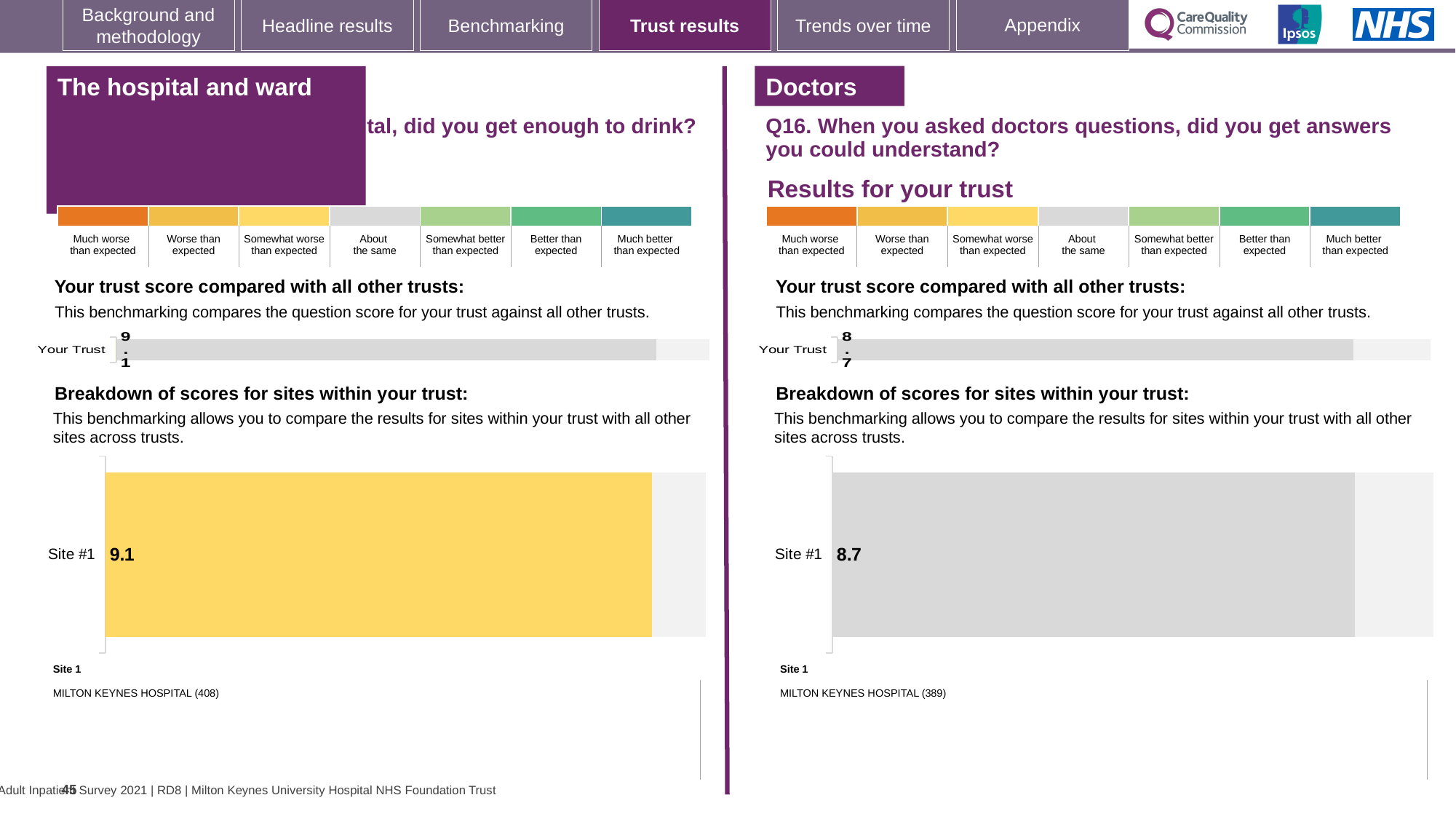
How many sites are plotted in the right-hand 'Breakdown of scores for sites within your trust' chart (Q16, Doctors)? 1 Which Site #1 score is larger: the one in the left-hand breakdown chart or the one in the right-hand (Q16, Doctors) breakdown chart? The left-hand chart (9.1) In the right-hand 'Breakdown of scores for sites within your trust' chart (Q16, Doctors), what is the score for Site #1? 8.7 What type of chart is used to show the Site #1 score in the left-hand 'Breakdown of scores for sites within your trust' section? Bar chart In the left-hand 'Your trust score compared with all other trusts' chart, what is the value shown for Your Trust? 9.1 What is the difference between the Site #1 score in the left-hand breakdown chart and the Site #1 score in the right-hand (Q16, Doctors) breakdown chart? 0.4 How many bars are plotted in the left-hand 'Your trust score compared with all other trusts' chart? 1 In the right-hand (Q16, Doctors) breakdown chart, which site name is listed for Site 1 below the chart? MILTON KEYNES HOSPITAL (389) What colour is the Site #1 bar in the left-hand 'Breakdown of scores for sites within your trust' chart? Yellow What colour is the Site #1 bar in the right-hand 'Breakdown of scores for sites within your trust' chart (Q16, Doctors)? Grey In the right-hand 'Your trust score compared with all other trusts' chart (Q16, Doctors), what is the value shown for Your Trust? 8.7 In the left-hand 'Breakdown of scores for sites within your trust' chart, what is the score for Site #1? 9.1